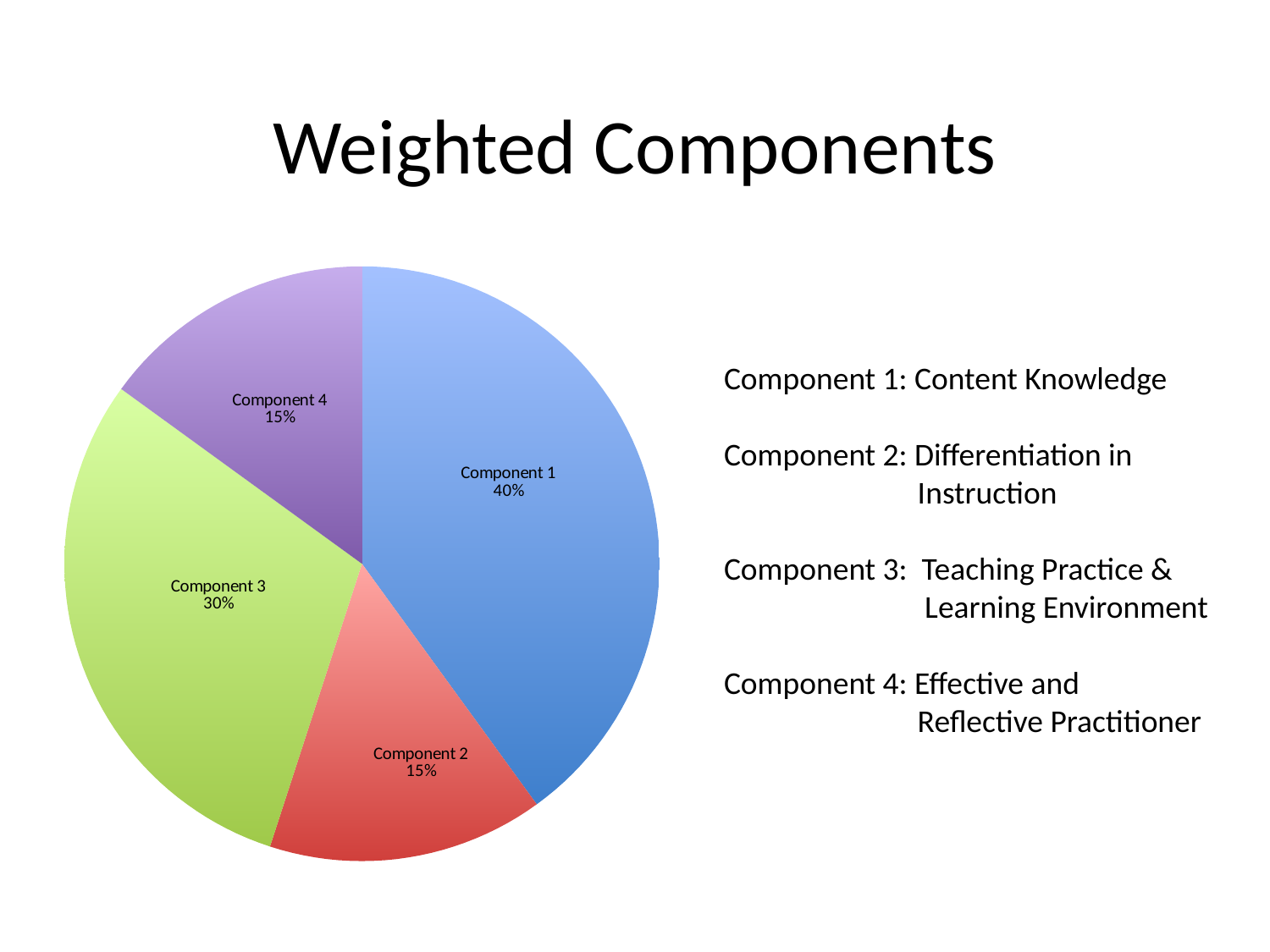
How many slices does the pie chart have? 4 What kind of chart is shown on the slide? Pie chart What share of the pie does Component 3 represent? 30% What is the difference in percentage points between Component 3 and Component 2? 15 What share of the pie does Component 4 represent? 15% What colour is the slice for Component 3? Green What share of the pie does Component 2 represent? 15% What is the combined share of Component 2 and Component 4? 30% Which is larger, the share for Component 1 or the share for Component 3? Component 1 What share of the pie does Component 1 represent? 40% What is the difference in percentage points between Component 1 and Component 3? 10 Which component has the largest share of the pie? Component 1